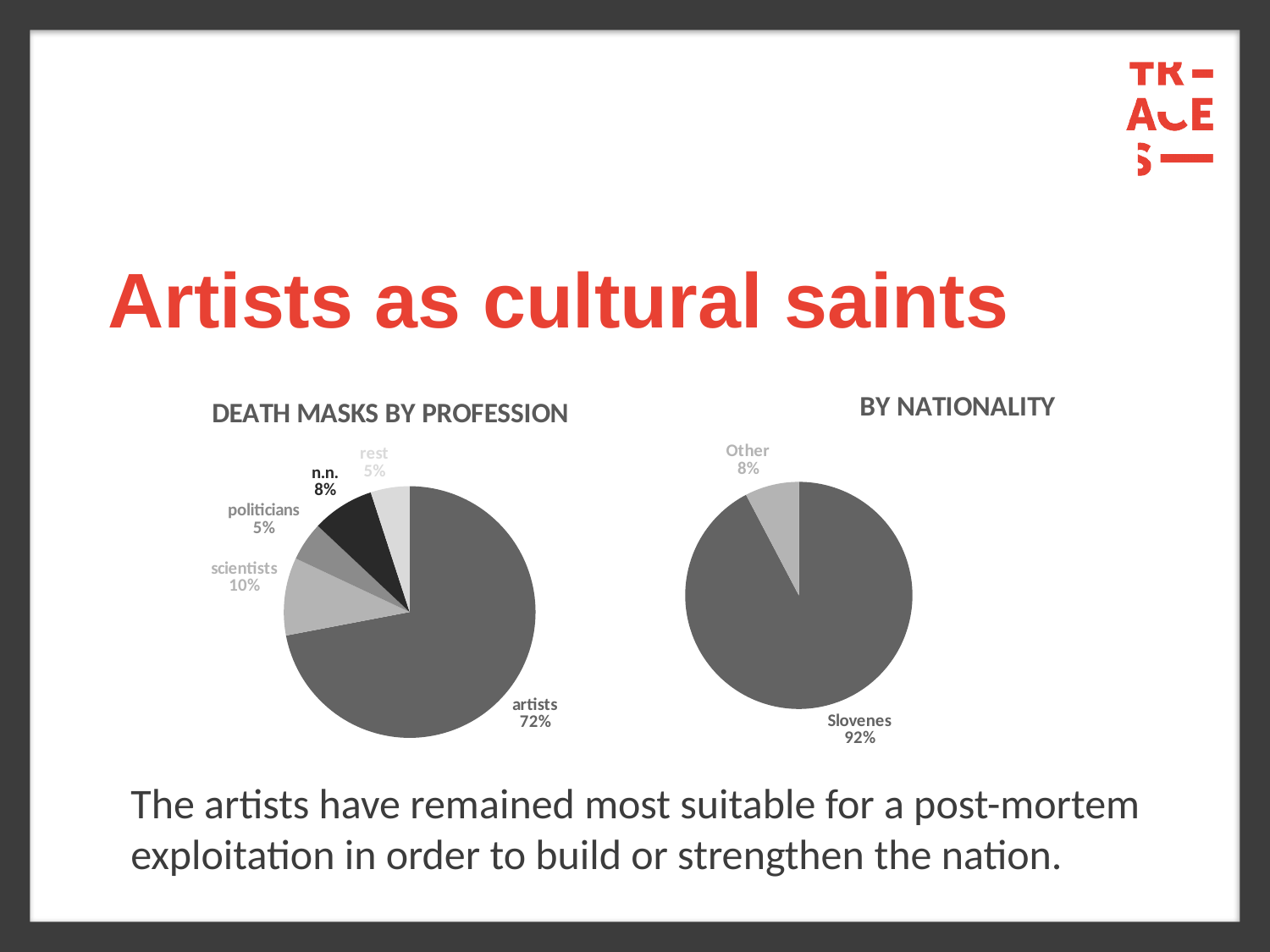
In the 'By nationality' chart, what share is shown for Other? 8% In the 'Death masks by profession' chart, which is larger, the scientists slice or the n.n. slice? scientists In the 'Death masks by profession' chart, which profession has the largest slice? artists In the 'Death masks by profession' chart, what is the difference in percentage points between artists and scientists? 62 In the 'By nationality' chart, what share is shown for Slovenes? 92% In the 'Death masks by profession' chart, how many slices does the pie have? 5 What is the title of the chart on the left of the slide? DEATH MASKS BY PROFESSION What type of chart is the 'By nationality' chart? pie chart In the 'Death masks by profession' chart, what share of death masks belongs to artists? 72% In the 'By nationality' chart, how many slices does the pie have? 2 In the 'Death masks by profession' chart, what percentage is shown for scientists? 10% In the 'Death masks by profession' chart, what percentage is shown for n.n.? 8%